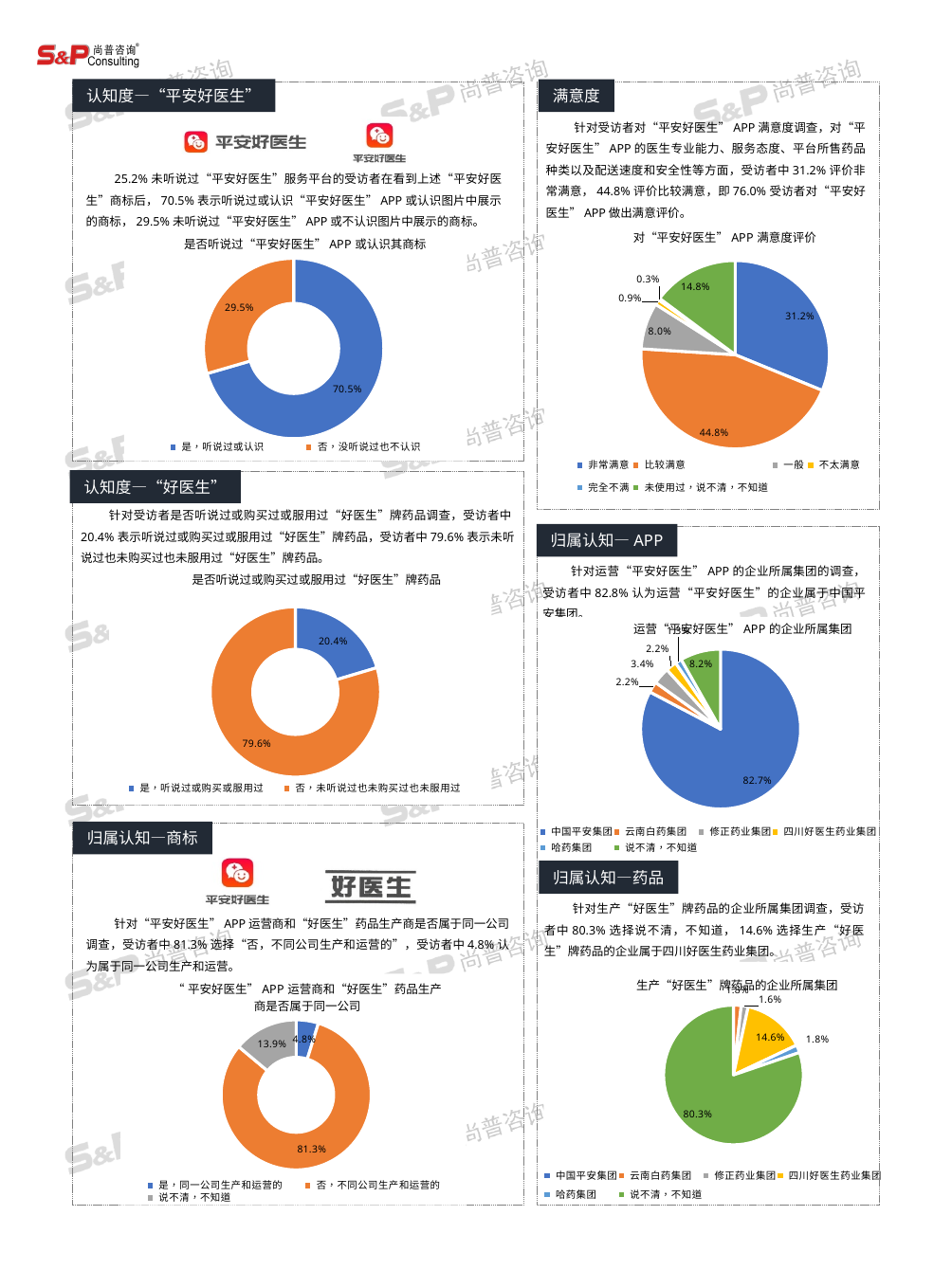
In the chart titled 生产"好医生"牌药品的企业所属集团, what share of respondents chose 四川好医生药业集团? 14.6% In the chart titled 对"平安好医生"APP满意度评价, how many categories does the legend list? 6 In the chart titled 对"平安好医生"APP满意度评价, which category has the smallest share? 完全不满 In the chart titled "平安好医生"APP运营商和"好医生"药品生产商是否属于同一公司, what share answered 说不清，不知道? 13.9% In the chart titled 是否听说过或购买过或服用过"好医生"牌药品, what percentage answered 否，未听说过也未购买过也未服用过? 79.6% In the chart titled "平安好医生"APP运营商和"好医生"药品生产商是否属于同一公司, which is larger: 是，同一公司生产和运营的 or 否，不同公司生产和运营的? 否，不同公司生产和运营的 In the chart titled 对"平安好医生"APP满意度评价, what share of respondents chose 比较满意? 44.8% In the chart titled 是否听说过"平安好医生"APP或认识其商标, what percentage of respondents answered 是，听说过或认识? 70.5% In the chart titled 对"平安好医生"APP满意度评价, which category has the largest share? 比较满意 In the chart titled 是否听说过"平安好医生"APP或认识其商标, what is the difference between the 是 share and the 否 share? 41.0% What type of chart is the one titled 是否听说过或购买过或服用过"好医生"牌药品? Donut (pie) chart In the chart titled 运营"平安好医生"APP的企业所属集团, what share of respondents chose 中国平安集团? 82.7%